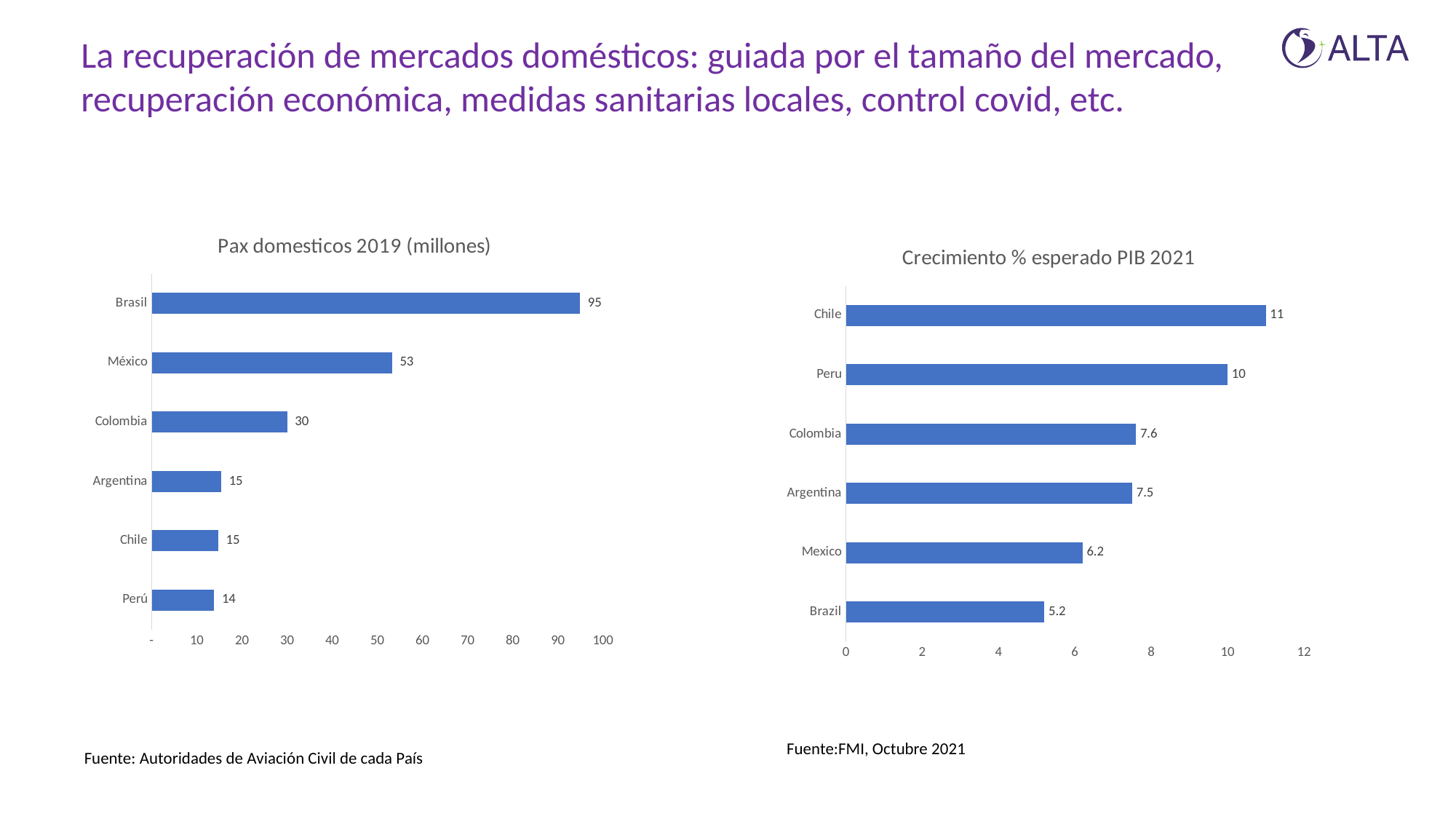
What type of chart is the 'Crecimiento % esperado PIB 2021' chart? Bar chart In the 'Pax domesticos 2019 (millones)' chart, which country has the lowest value? Perú In the 'Crecimiento % esperado PIB 2021' chart, what is the difference between Chile and Brazil? 5.8 In the 'Crecimiento % esperado PIB 2021' chart, what is the value for Peru? 10 In the 'Pax domesticos 2019 (millones)' chart, what is the value for Brasil? 95 In the 'Crecimiento % esperado PIB 2021' chart, which country has the highest value? Chile In the 'Pax domesticos 2019 (millones)' chart, what is the difference between Brasil and México? 42 In the 'Crecimiento % esperado PIB 2021' chart, which is larger, the value for Colombia or the value for Mexico? Colombia In the 'Pax domesticos 2019 (millones)' chart, what is the value for Colombia? 30 In the 'Crecimiento % esperado PIB 2021' chart, what is the value for Mexico? 6.2 In the 'Pax domesticos 2019 (millones)' chart, how many countries are shown? 6 In the 'Crecimiento % esperado PIB 2021' chart, which country has the lowest value? Brazil